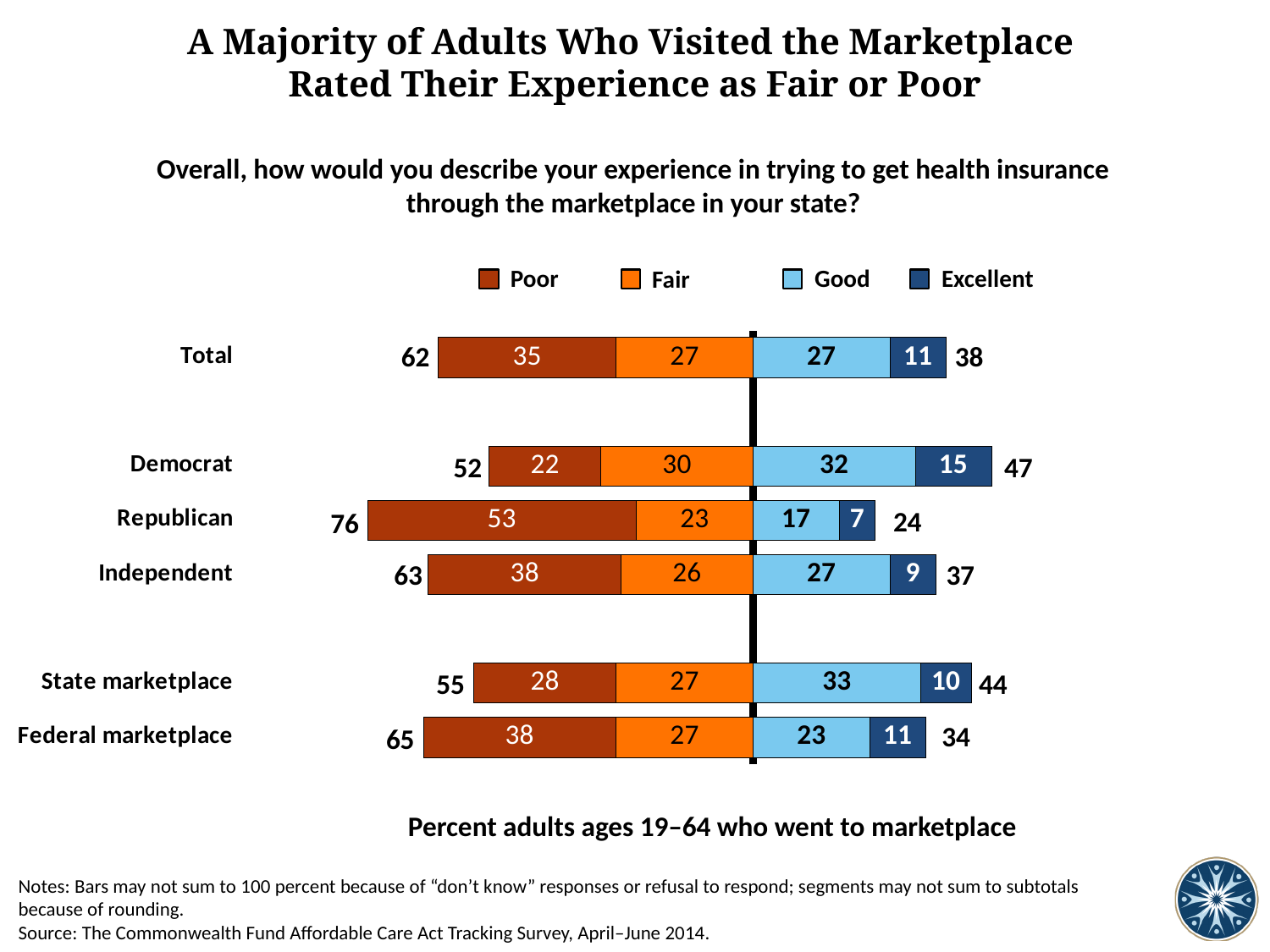
What is the combined Fair or Poor subtotal shown for Independent? 63 What is the combined Good or Excellent subtotal shown for State marketplace? 44 What is the difference between the Poor values for Republican and Democrat? 31 Which group has the lowest Excellent value? Republican Which group has the highest Poor value? Republican What percent of Democrats rated their experience as Excellent? 15 What percent of Republicans rated their experience as Poor? 53 How many series does the legend list? 4 How many groups (bars) are shown in the chart? 6 What is the Good value for the State marketplace group? 33 What kind of chart is shown on the slide? Stacked bar chart Which is larger, the Good value for Democrat or the Good value for Federal marketplace? Democrat